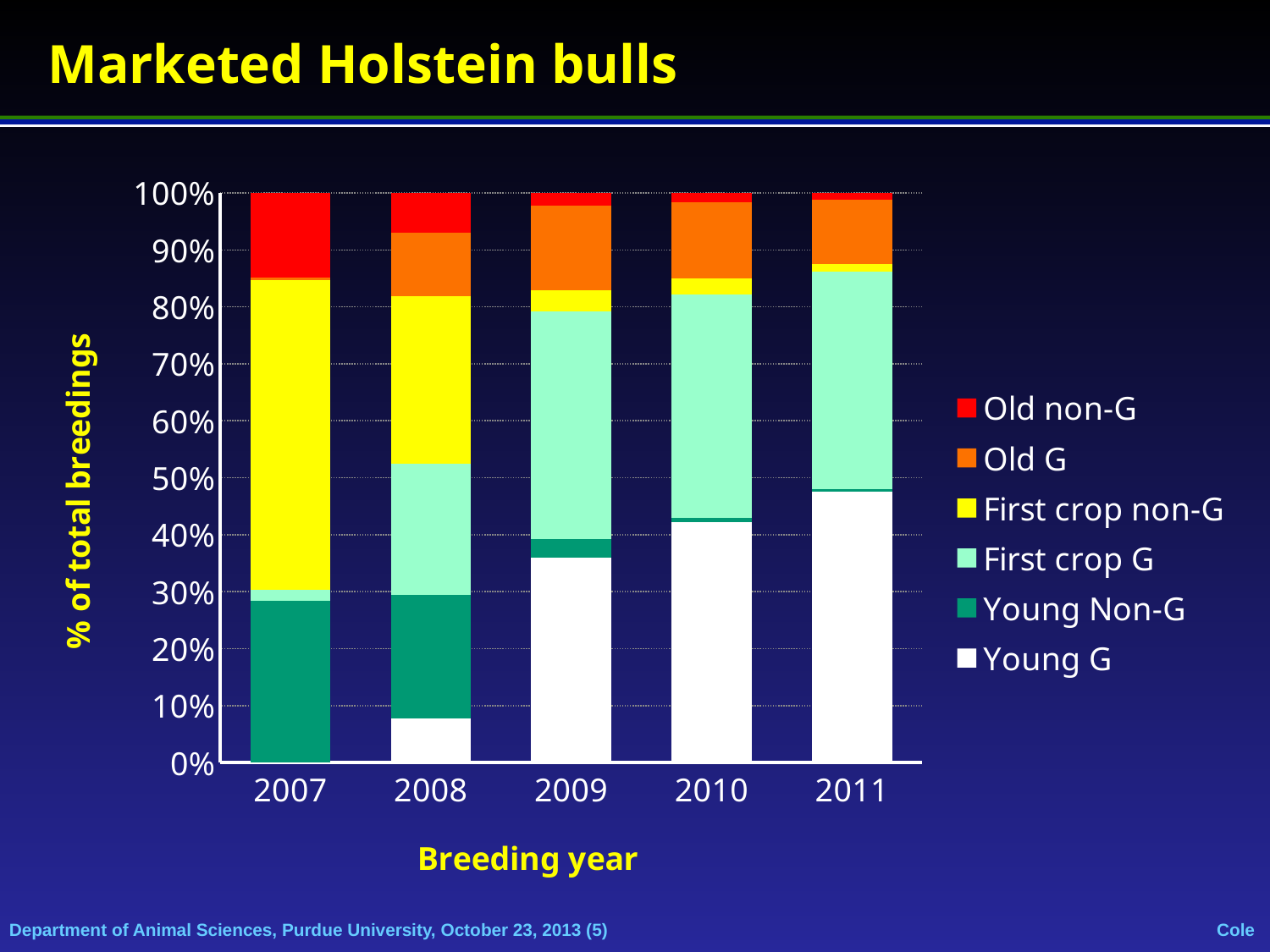
Which breeding year has the largest Old non-G segment? 2007 How many series does the legend list? 6 Is the Young G segment for 2008 greater or less than 10%? less What kind of chart is shown on the slide? Stacked bar chart What is the title of the chart? Marketed Holstein bulls Which is larger, the Young G segment for 2009 or for 2011? 2011 Which breeding year has the largest Young G segment? 2011 Does the Young G share rise or fall from 2007 to 2011? rise How many breeding years are shown on the x axis? 5 What is the label of the y axis? % of total breedings Is the Young G segment for 2011 greater or less than 40%? greater Which breeding year has the largest First crop non-G segment? 2007